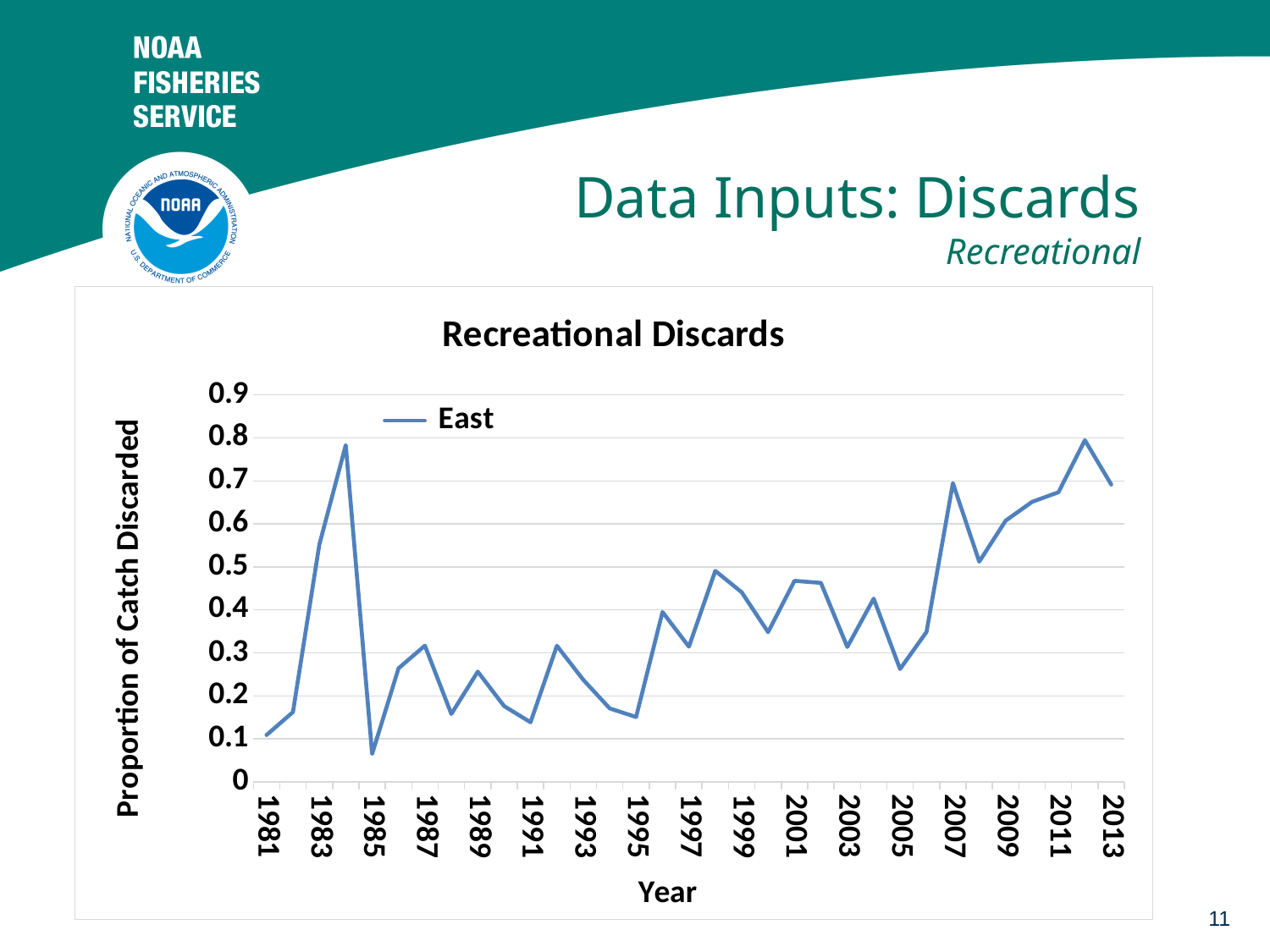
How many series does the legend list? 1 Which year has the larger value, 2005 or 2007? 2007 Do the values generally rise or fall between 2005 and 2012? rise Is the value for 1995 greater or less than 0.2? less Which year has the lowest proportion of catch discarded? 1985 Is the value for 1985 greater or less than 0.1? less Which year has the larger value, 1984 or 1985? 1984 What kind of chart is shown on the slide? line chart What is the name of the series shown in the legend? East Is the value for 2005 greater or less than 0.3? less What is the title of the chart? Recreational Discards